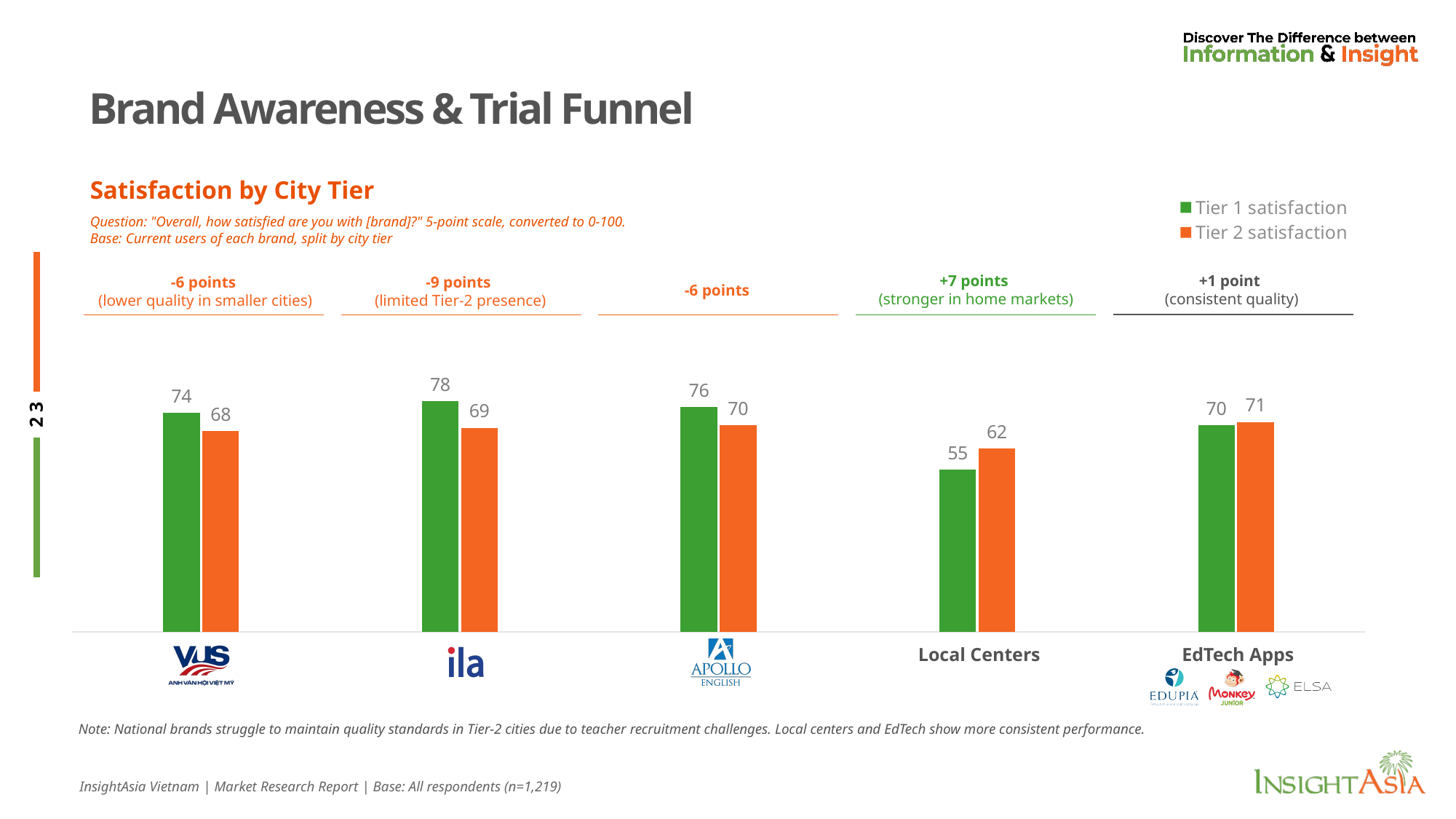
Which brand has the highest Tier 2 satisfaction score? EdTech Apps What type of chart is used to show satisfaction by city tier? Bar chart Which is larger for Local Centers: Tier 1 satisfaction or Tier 2 satisfaction? Tier 2 satisfaction What is the difference between Tier 1 and Tier 2 satisfaction for Apollo English? 6 What is the Tier 2 satisfaction score for VUS? 68 What is the Tier 2 satisfaction score for Local Centers? 62 Which colour represents Tier 2 satisfaction in the chart? Orange How many brands or brand groups are shown on the x axis of the chart? 5 Which brand has the highest Tier 1 satisfaction score? ILA How many series does the legend list? 2 What is the Tier 1 satisfaction score for ILA? 78 Which brand has the lowest Tier 1 satisfaction score? Local Centers